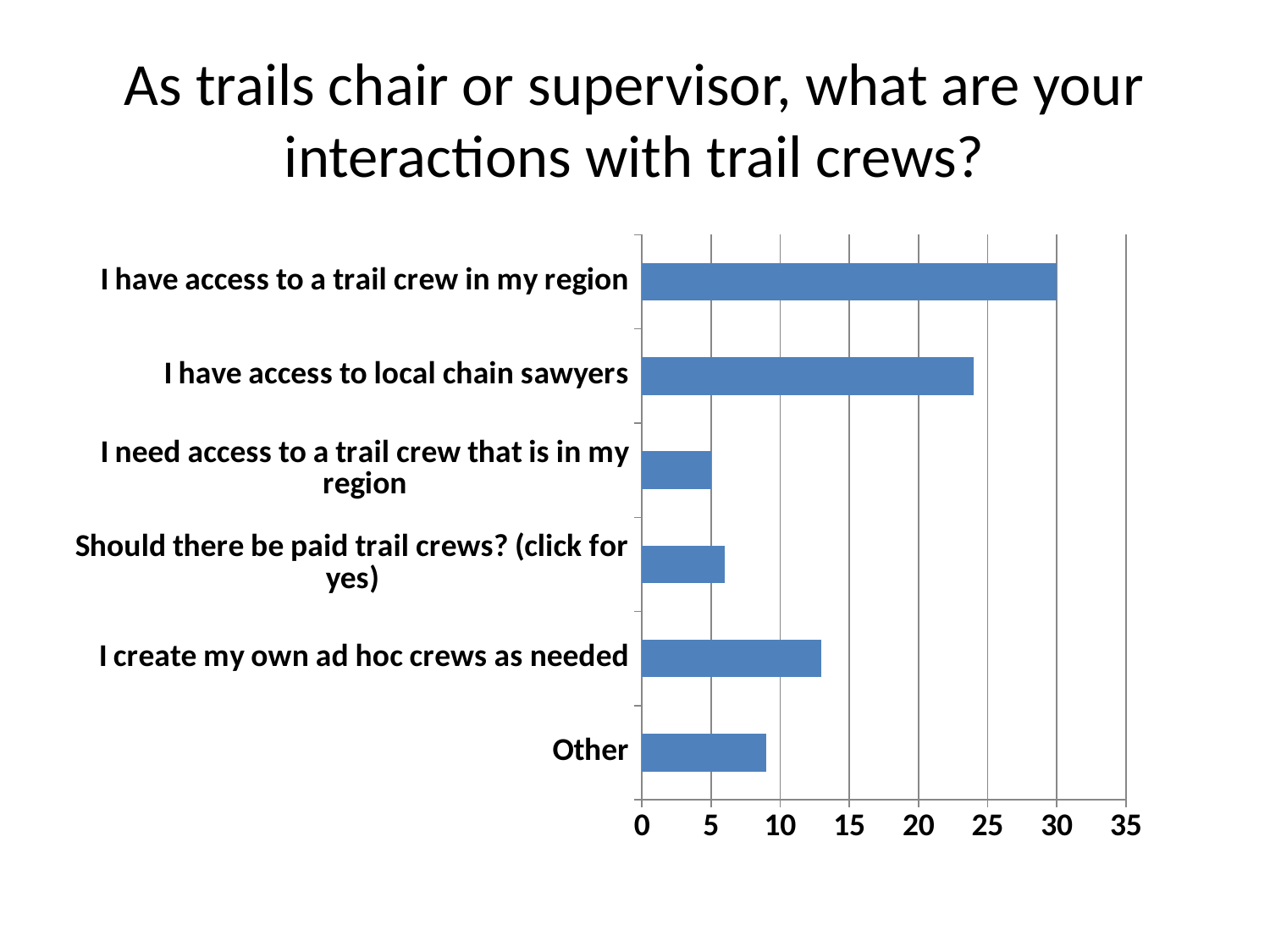
What kind of chart is shown on the slide? bar chart Which is larger: the value for "I have access to local chain sawyers" or the value for "I create my own ad hoc crews as needed"? I have access to local chain sawyers What is the title of the slide containing the chart? As trails chair or supervisor, what are your interactions with trail crews? Which category has the highest value? I have access to a trail crew in my region Is the value for "Other" greater or less than 10? less Is the value for "I have access to local chain sawyers" greater or less than 20? greater How many categories are shown in the chart? 6 Is the value for "Other" greater or less than 5? greater What is the value for "I need access to a trail crew that is in my region"? 5 Which is larger: the value for "Other" or the value for "I have access to a trail crew in my region"? I have access to a trail crew in my region What is the value for "I have access to a trail crew in my region"? 30